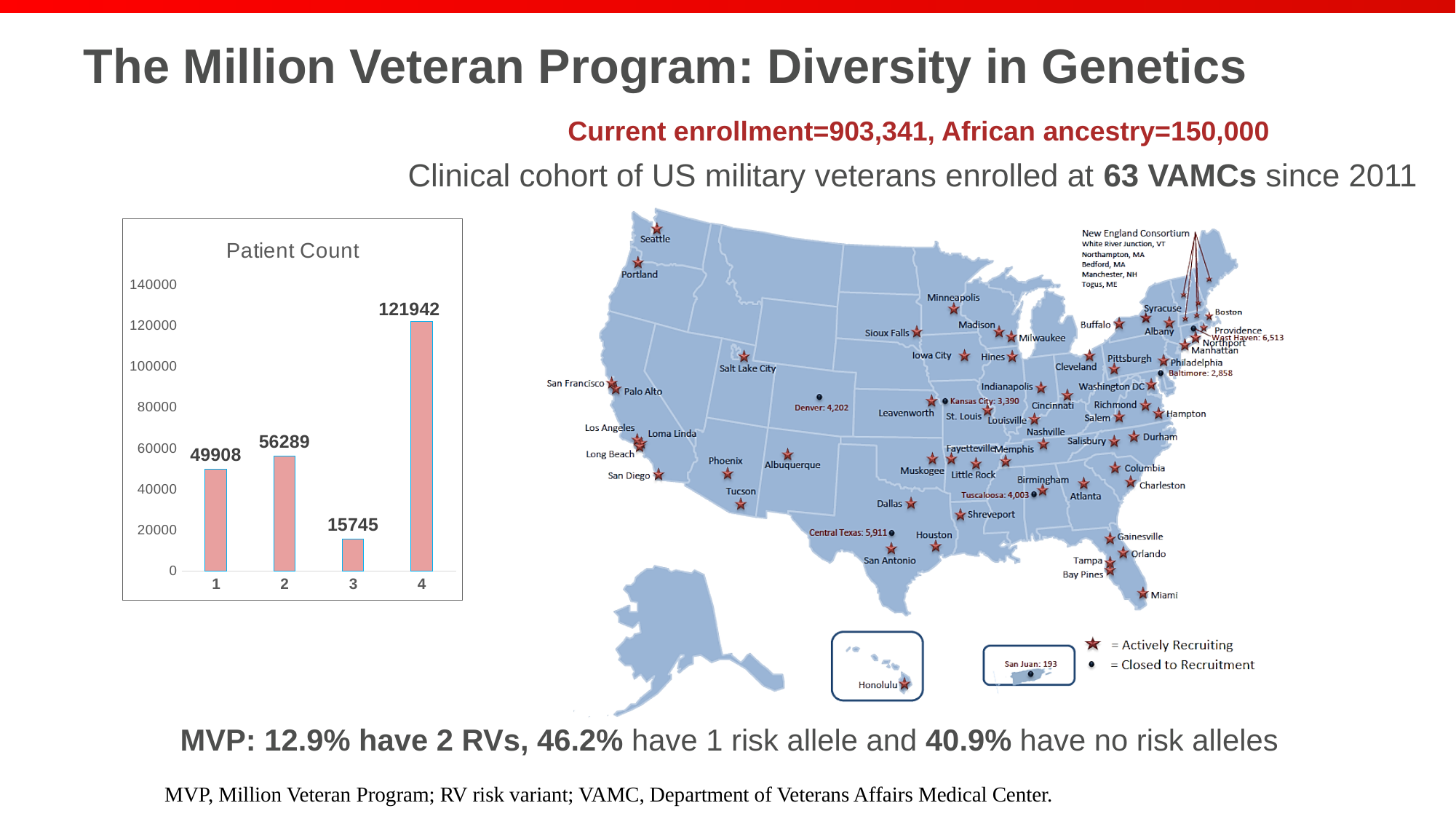
What is the Patient Count for category 2? 56289 What is the Patient Count for category 3? 15745 What is the Patient Count for category 4? 121942 Which has a larger Patient Count, category 1 or category 2? 2 What is the difference in Patient Count between category 2 and category 3? 40544 What is the difference in Patient Count between category 4 and category 1? 72034 Is the Patient Count for category 4 greater or less than 100000? greater Which category has the lowest Patient Count? 3 What is the Patient Count for category 1? 49908 Which category has the highest Patient Count? 4 How many categories are shown in the Patient Count chart? 4 What kind of chart is the Patient Count chart? bar chart